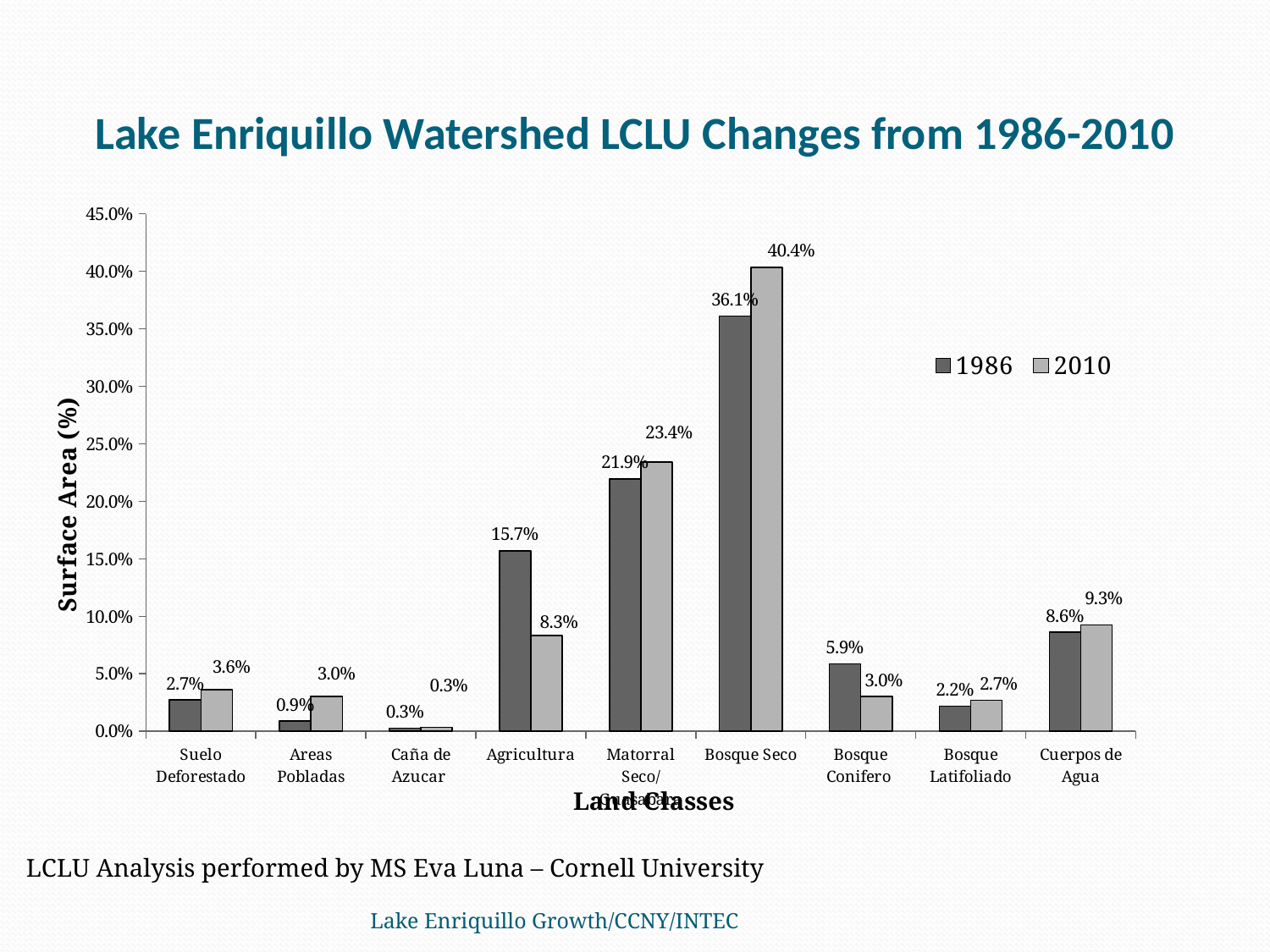
Which land class had the highest surface area percentage in 1986? Bosque Seco What is the difference between the 1986 and 2010 values for Agricultura? 7.4 percentage points How many land classes are shown on the x axis? 9 What type of chart is shown on the slide? Bar chart Which land class had the lowest surface area percentage in 2010? Caña de Azucar How many series does the legend list? 2 By how many percentage points did the surface area of Bosque Seco change from 1986 to 2010? 4.3 percentage points Is the 2010 value for Bosque Seco greater or less than 40.0%? greater What was the surface area percentage for Bosque Seco in 2010? 40.4% What was the surface area percentage for Agricultura in 1986? 15.7% For Bosque Conifero, which year had the larger surface area percentage, 1986 or 2010? 1986 What was the surface area percentage for Areas Pobladas in 2010? 3.0%